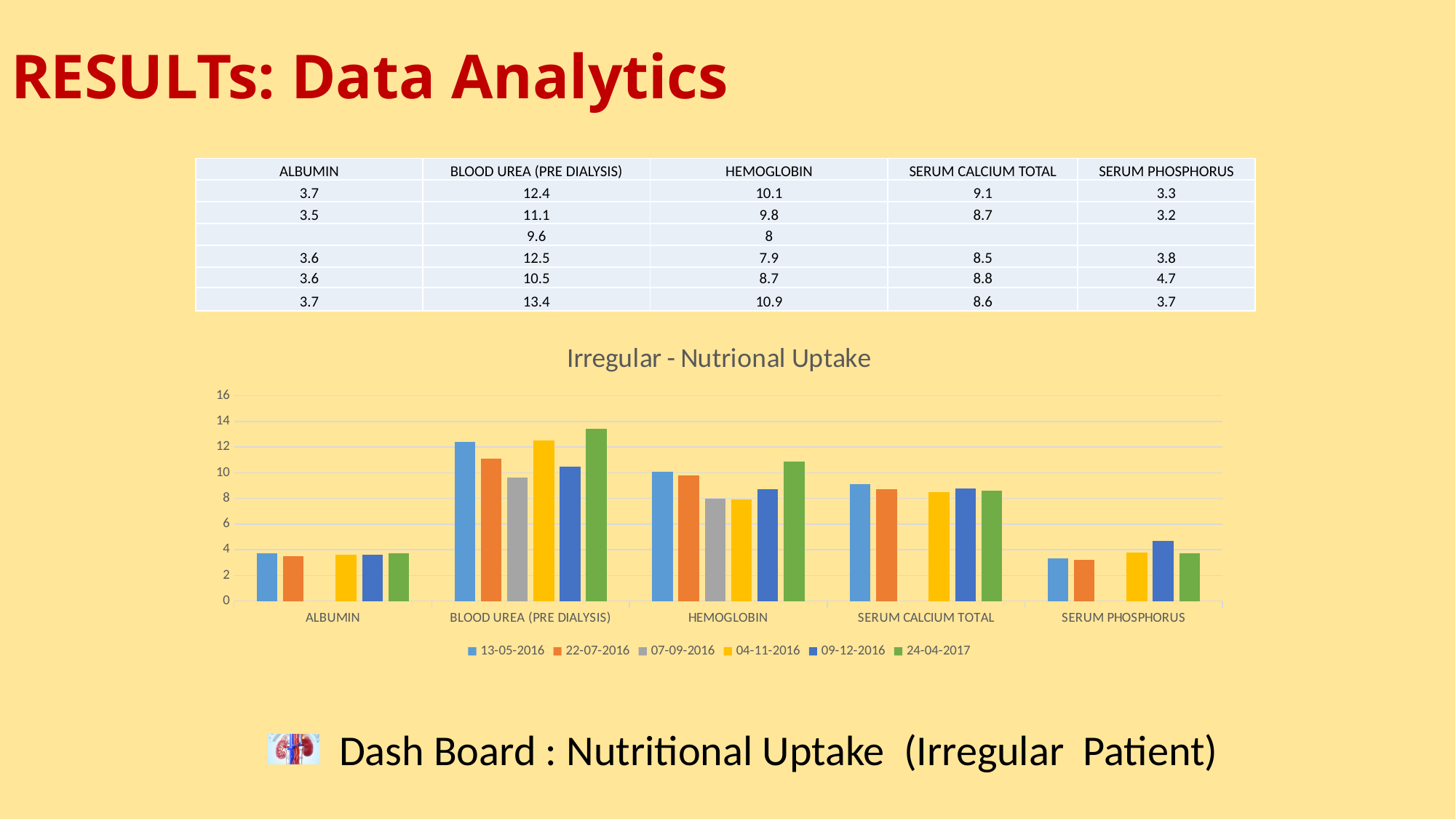
What is the SERUM PHOSPHORUS value for 09-12-2016? 4.7 Which series has no bar for ALBUMIN, SERUM CALCIUM TOTAL and SERUM PHOSPHORUS? 07-09-2016 What kind of chart is shown under the title 'Irregular - Nutrional Uptake'? bar chart How many categories are shown on the x axis of the chart? 5 How many series does the legend of the chart list? 6 What is the difference between the BLOOD UREA (PRE DIALYSIS) values for 24-04-2017 and 07-09-2016? 3.8 What is the title of the chart? Irregular - Nutrional Uptake What is the HEMOGLOBIN value for 24-04-2017? 10.9 Which series has the highest value for BLOOD UREA (PRE DIALYSIS)? 24-04-2017 Is the HEMOGLOBIN value for 07-09-2016 greater or less than 10? less Which series has the lowest value for BLOOD UREA (PRE DIALYSIS)? 07-09-2016 Which is larger for HEMOGLOBIN: the value for 13-05-2016 or the value for 09-12-2016? 13-05-2016